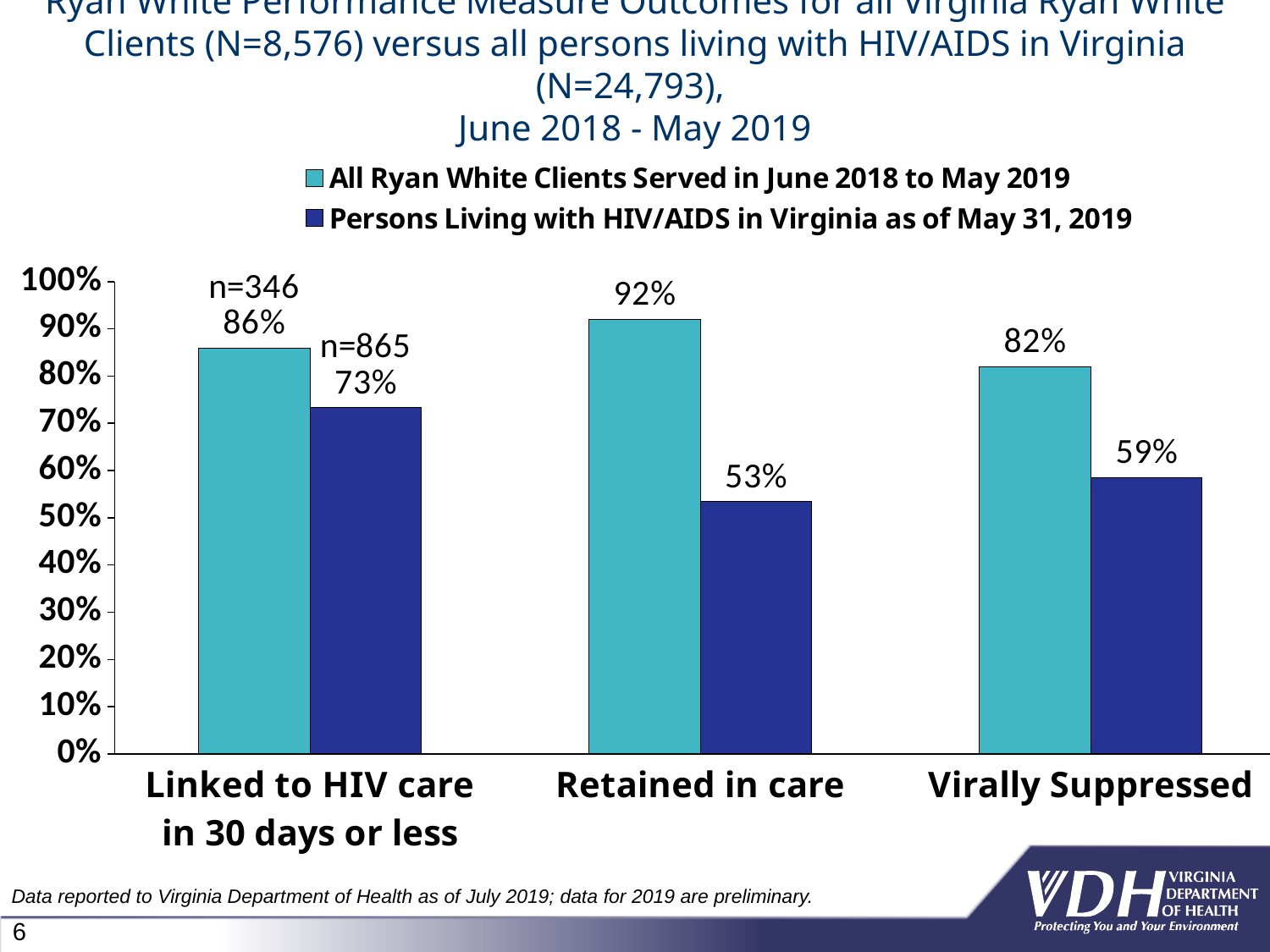
What is the n value shown above the All Ryan White Clients bar for Linked to HIV care in 30 days or less? n=346 How many measures (categories) are shown on the x axis? 3 What percentage of Persons Living with HIV/AIDS in Virginia as of May 31, 2019 were Virally Suppressed? 59% What kind of chart is shown on the slide? Bar chart What is the difference between the two series for Virally Suppressed? 23% What percentage of All Ryan White Clients Served in June 2018 to May 2019 were Retained in care? 92% What is the difference between the two series for Retained in care? 39% For which measure is the value for All Ryan White Clients Served in June 2018 to May 2019 the highest? Retained in care What percentage of Persons Living with HIV/AIDS in Virginia as of May 31, 2019 were Linked to HIV care in 30 days or less? 73% For which measure is the value for Persons Living with HIV/AIDS in Virginia as of May 31, 2019 the lowest? Retained in care How many series does the legend list? 2 Which series has the larger value for Linked to HIV care in 30 days or less? All Ryan White Clients Served in June 2018 to May 2019